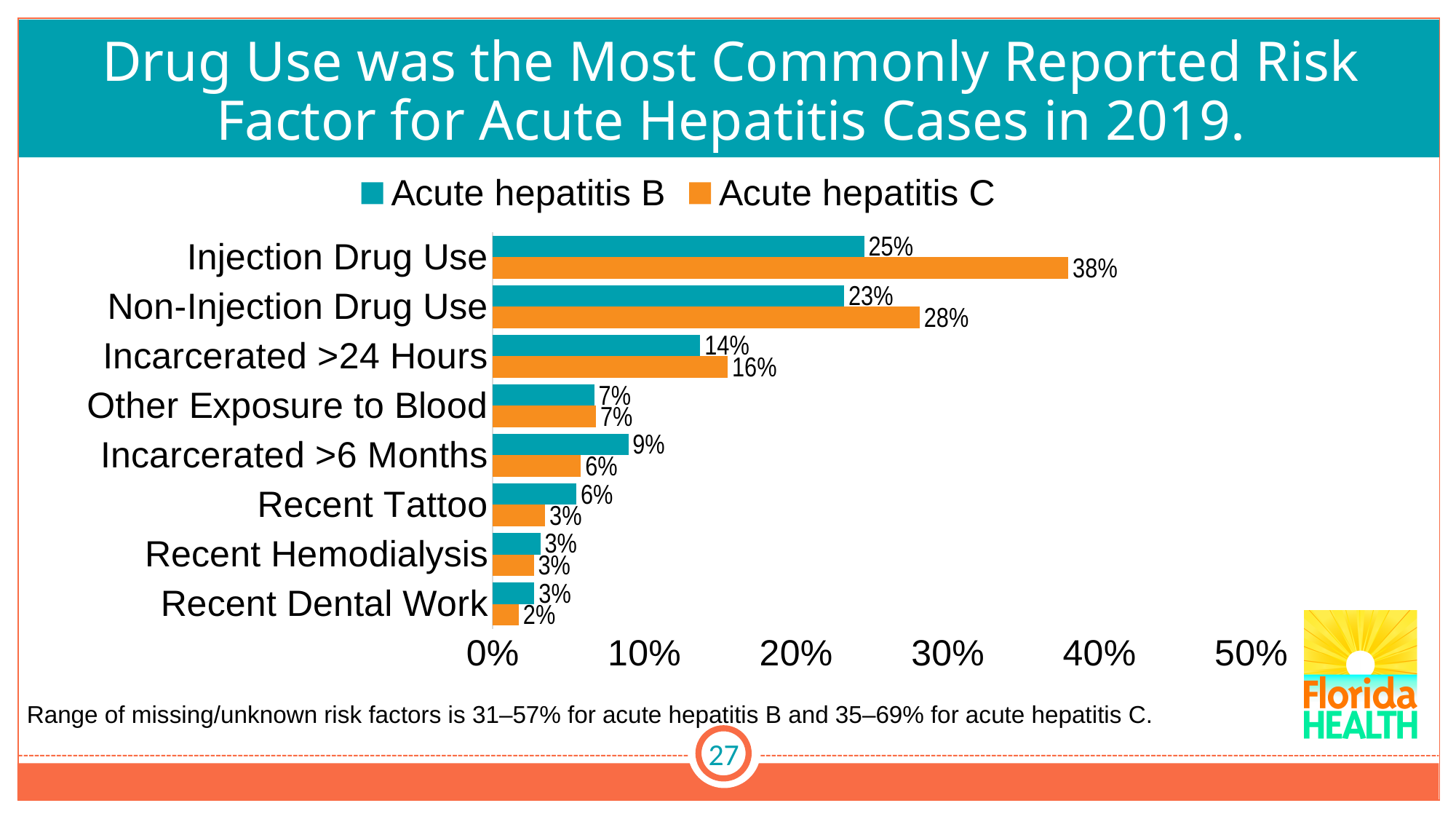
For Incarcerated >6 Months, which series has the larger value, Acute hepatitis B or Acute hepatitis C? Acute hepatitis B Which colour represents the Acute hepatitis C series? Orange What is the value for Injection Drug Use in the Acute hepatitis C series? 38% What kind of chart is shown on the slide? Bar chart How many risk factor categories are shown on the chart? 8 What is the value for Incarcerated >24 Hours in the Acute hepatitis C series? 16% Which risk factor has the highest value in the Acute hepatitis C series? Injection Drug Use Is the value for Non-Injection Drug Use in the Acute hepatitis C series greater or less than 20%? greater How many series does the legend list? 2 What is the value for Non-Injection Drug Use in the Acute hepatitis B series? 23% What is the difference between the Acute hepatitis C and Acute hepatitis B values for Injection Drug Use? 13% Which risk factor has the lowest value in the Acute hepatitis C series? Recent Dental Work